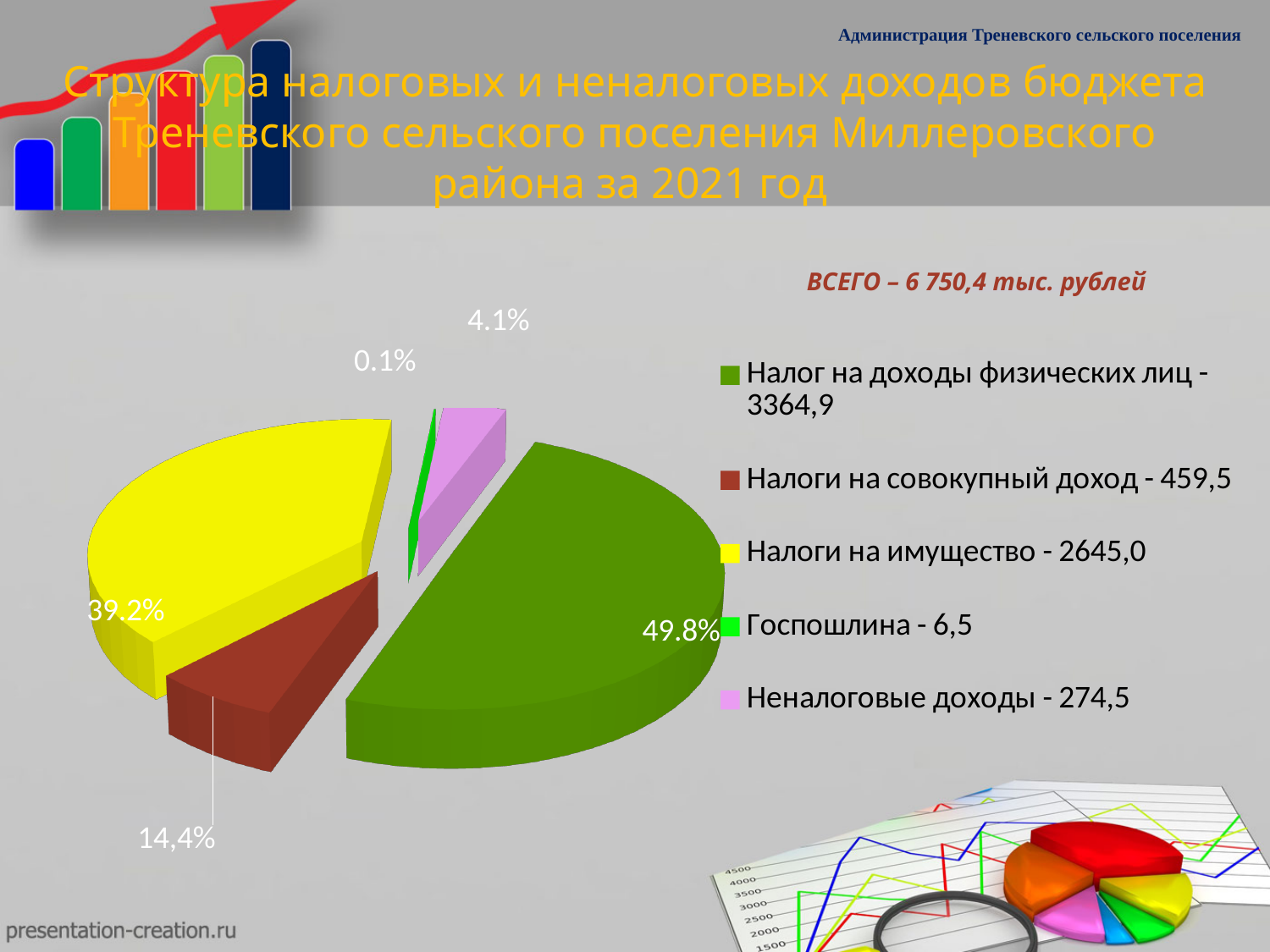
What is the difference between the legend values for Налог на доходы физических лиц and Налоги на имущество? 719,9 Which category has the largest slice of the pie? Налог на доходы физических лиц What value is given in the legend for Налоги на совокупный доход? 459,5 What percentage share of the pie does the slice for Налог на доходы физических лиц have? 49.8% Which is larger, Налоги на имущество or Налоги на совокупный доход? Налоги на имущество What type of chart is shown on the slide? pie chart What percentage share of the pie does the slice for Налоги на имущество have? 39.2% What value is given in the legend for Налог на доходы физических лиц? 3364,9 What percentage share of the pie does the slice for Госпошлина have? 0.1% How many categories does the pie chart's legend list? 5 Which category has the smallest slice of the pie? Госпошлина